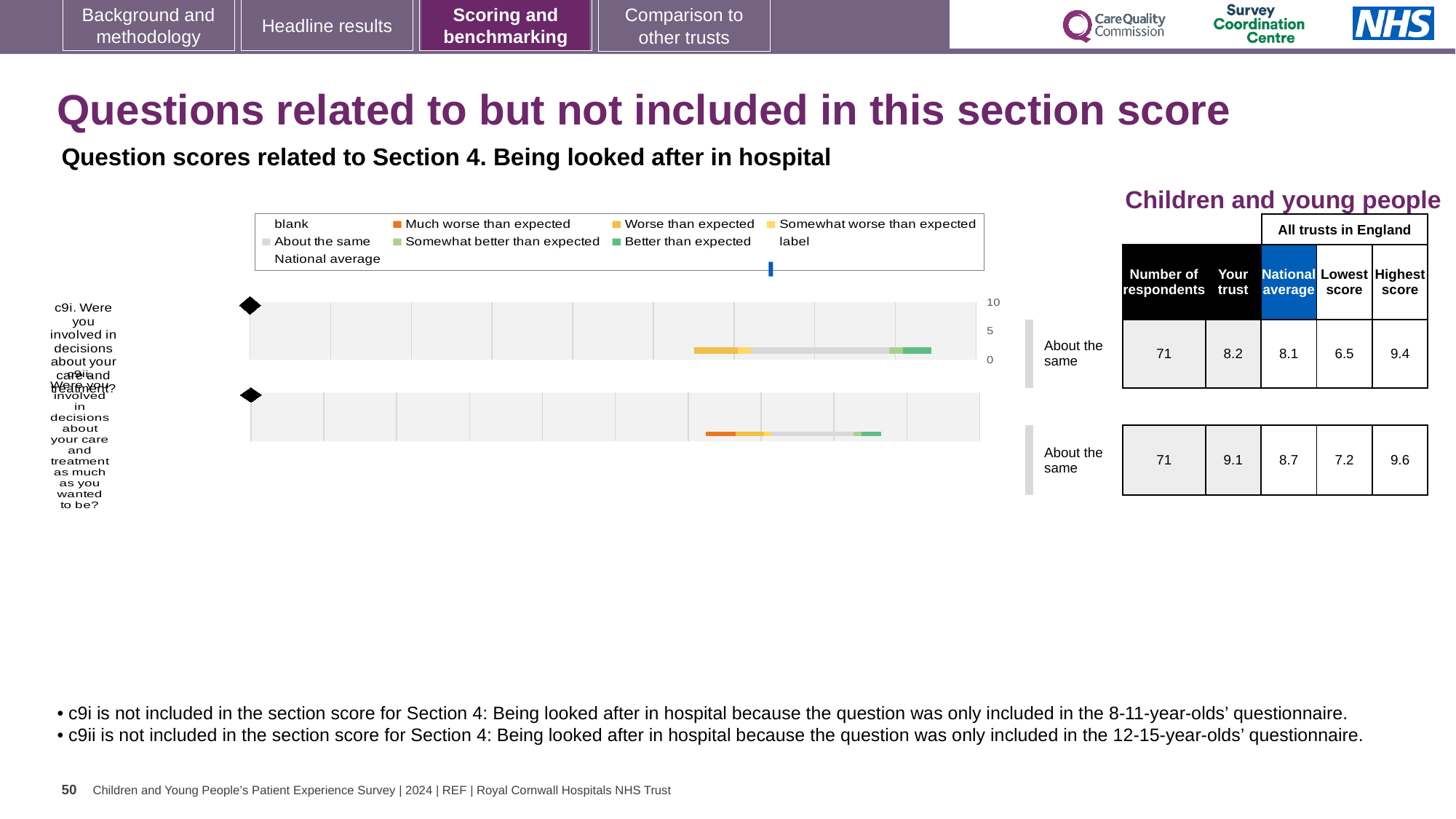
What colour represents 'Much worse than expected' in the chart legend? orange How many entries does the chart legend list? 9 What is the highest value shown on the chart's axis? 10 In the table beside the chart, what is the difference between the highest score and the lowest score for c9i? 2.9 In the table beside the chart, which question has the higher 'Your trust' score, c9i or c9ii? c9ii How many questions (bars) are plotted in the chart? 2 What kind of chart is shown on the slide? bar chart In the table beside the chart, what is the national average for c9ii? 8.7 In the table beside the chart, what is the number of respondents for c9i? 71 In the table beside the chart, what is the difference between the 'Your trust' score and the national average for c9ii? 0.4 In the table beside the chart, what is the 'Your trust' score for c9i? 8.2 In the table beside the chart, what is the 'Your trust' score for c9ii? 9.1